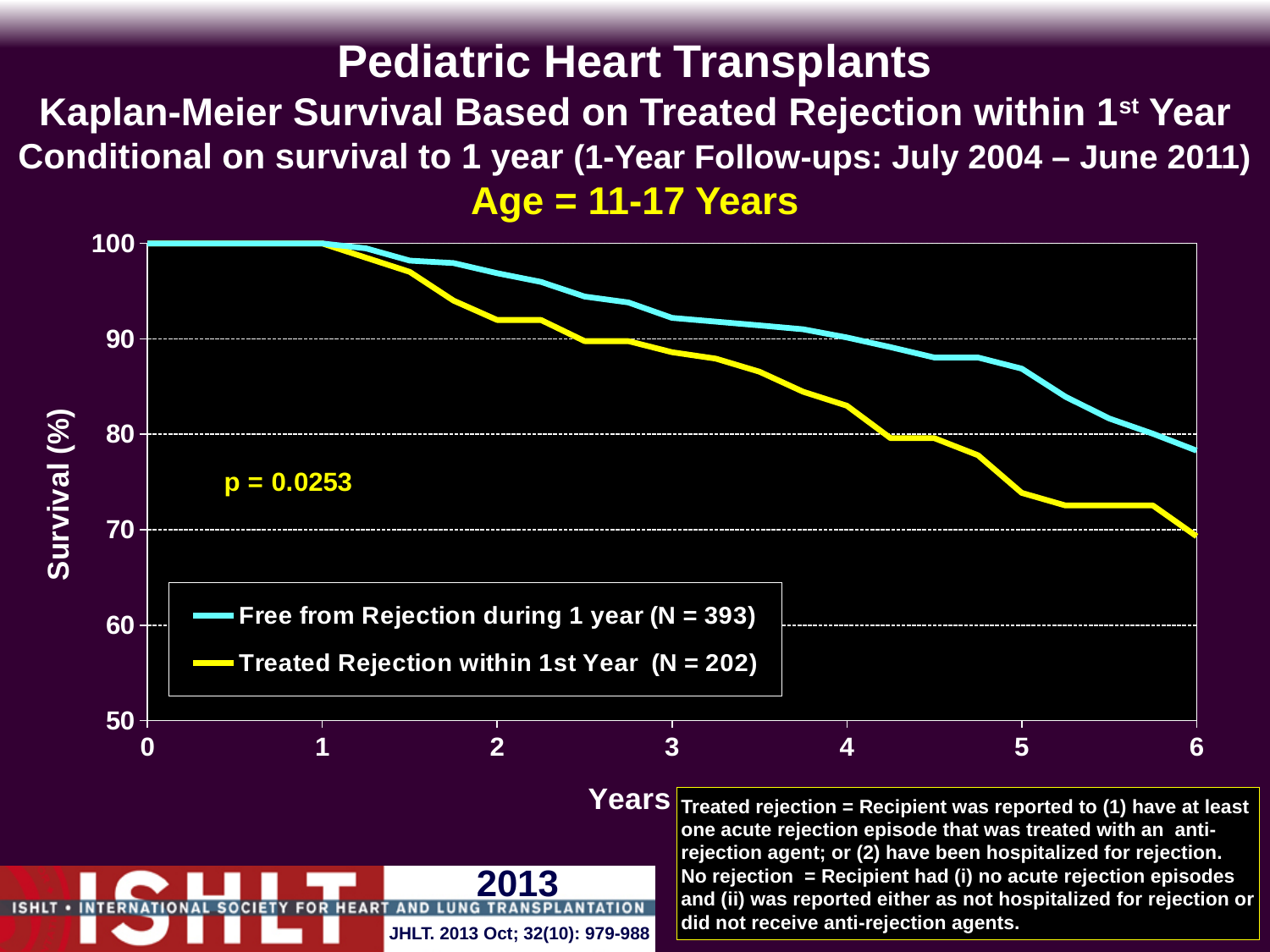
Is the survival for the 'Free from Rejection during 1 year' group at 6 years greater or less than 80? less What is the N for the 'Treated Rejection within 1st Year' group? 202 How many series does the legend list? 2 What is the p-value printed on the chart? p = 0.0253 Which colour is used for the 'Treated Rejection within 1st Year' line? Yellow Is the survival for the 'Treated Rejection within 1st Year' group at 5 years greater or less than 80? less At 5 years, which group has the higher survival: 'Free from Rejection during 1 year' or 'Treated Rejection within 1st Year'? Free from Rejection during 1 year What kind of chart is shown on the slide? Line chart Is the survival for the 'Free from Rejection during 1 year' group at 3 years greater or less than 90? greater What is the label of the y-axis? Survival (%) What is the N for the 'Free from Rejection during 1 year' group? 393 Do the survival curves rise or fall as years increase? Fall